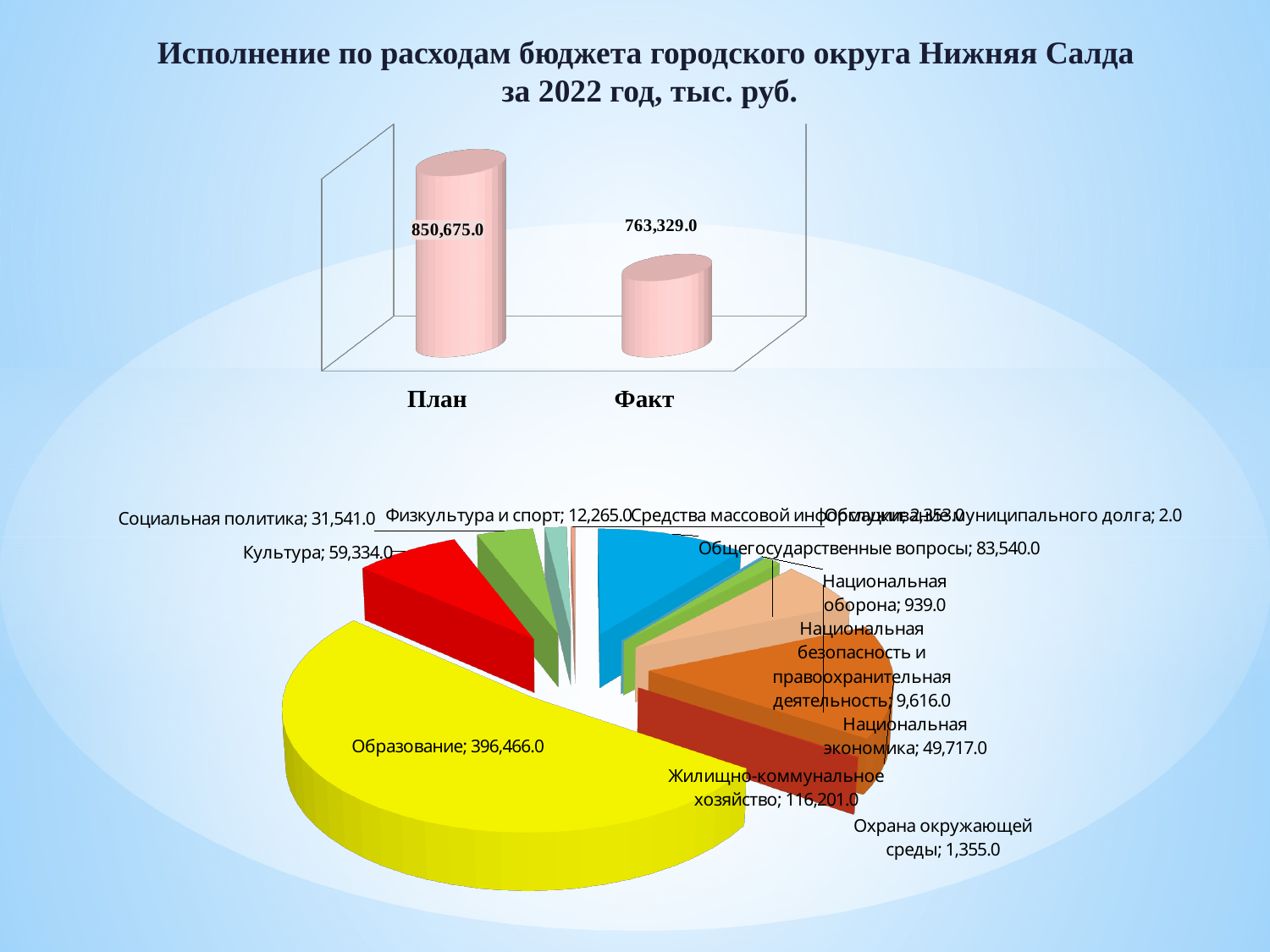
In the bottom pie chart, what is the value for Жилищно-коммунальное хозяйство? 116,201.0 In the top bar chart, what is the difference between План and Факт? 87,346.0 In the top bar chart, what is the value for Факт? 763,329.0 In the bottom pie chart, what is the value for Общегосударственные вопросы? 83,540.0 In the bottom pie chart, which is larger, Культура or Национальная экономика? Культура In the top bar chart, which is larger, План or Факт? План In the top bar chart, what is the value for План? 850,675.0 In the bottom pie chart, which category has the largest value? Образование In the bottom pie chart, what is the difference between Жилищно-коммунальное хозяйство and Общегосударственные вопросы? 32,661.0 What kind of chart is the top chart on the slide? Bar chart How many bars does the top chart show? 2 What kind of chart is the bottom chart on the slide? Pie chart